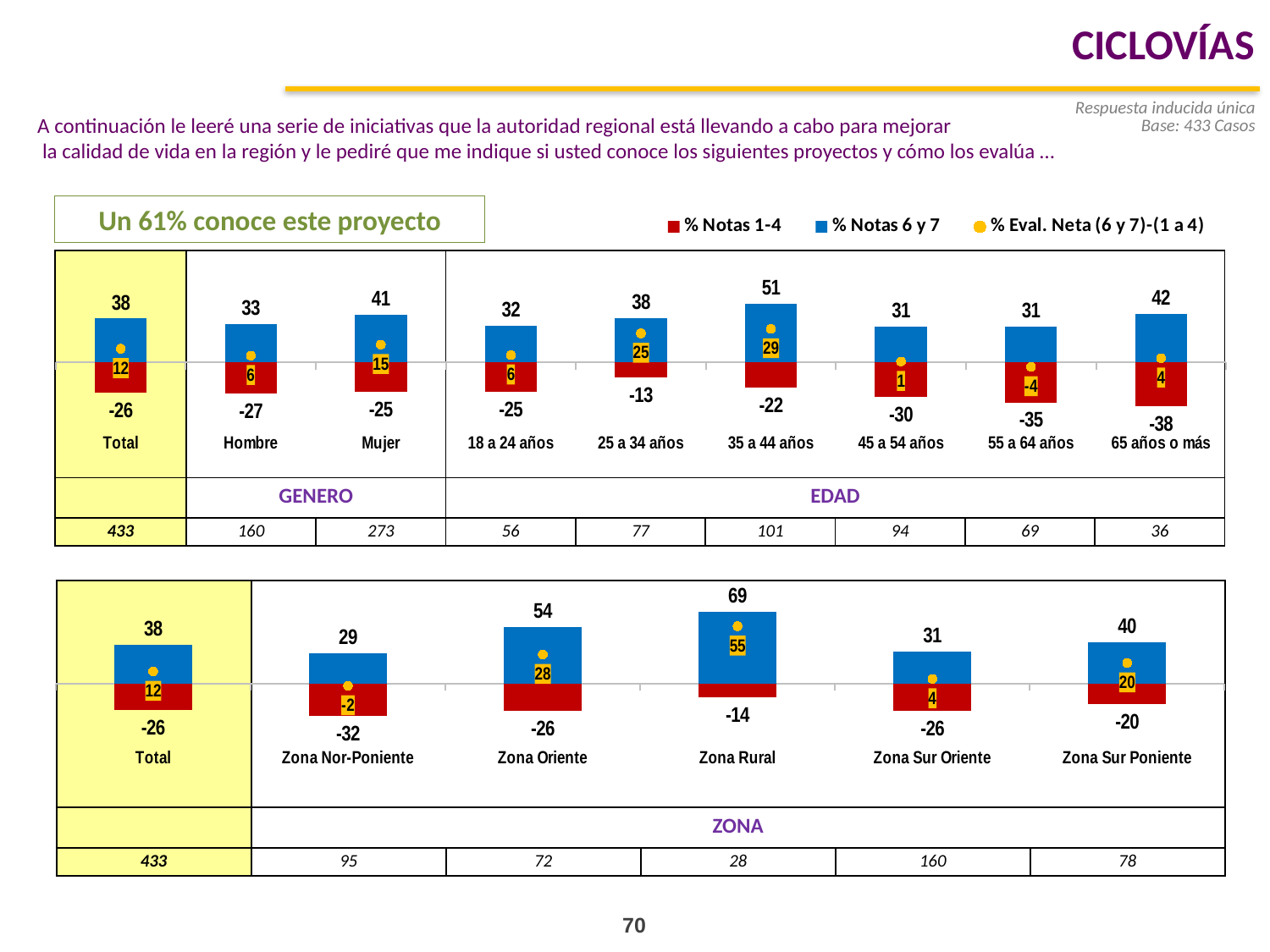
In the top chart, what is the % Notas 6 y 7 value for Mujer? 41 In the top chart, which category has the lowest % Eval. Neta value? 55 a 64 años In the top chart, what is the % Notas 1-4 value for 55 a 64 años? -35 In the top chart, what is the % Eval. Neta value for 35 a 44 años? 29 In the bottom chart, which zone has the highest % Eval. Neta value? Zona Rural In the bottom chart, what is the % Notas 6 y 7 value for Zona Rural? 69 In the bottom chart, which is larger, the % Notas 6 y 7 value for Zona Oriente or for Zona Sur Poniente? Zona Oriente How many zone categories (excluding Total) are shown in the bottom chart? 5 In the top chart, what is the difference between the % Notas 6 y 7 values for Mujer and Hombre? 8 In the top chart, which age group has the highest % Notas 6 y 7 value? 35 a 44 años In the bottom chart, what is the % Eval. Neta value for Zona Nor-Poniente? -2 How many series does the legend list? 3